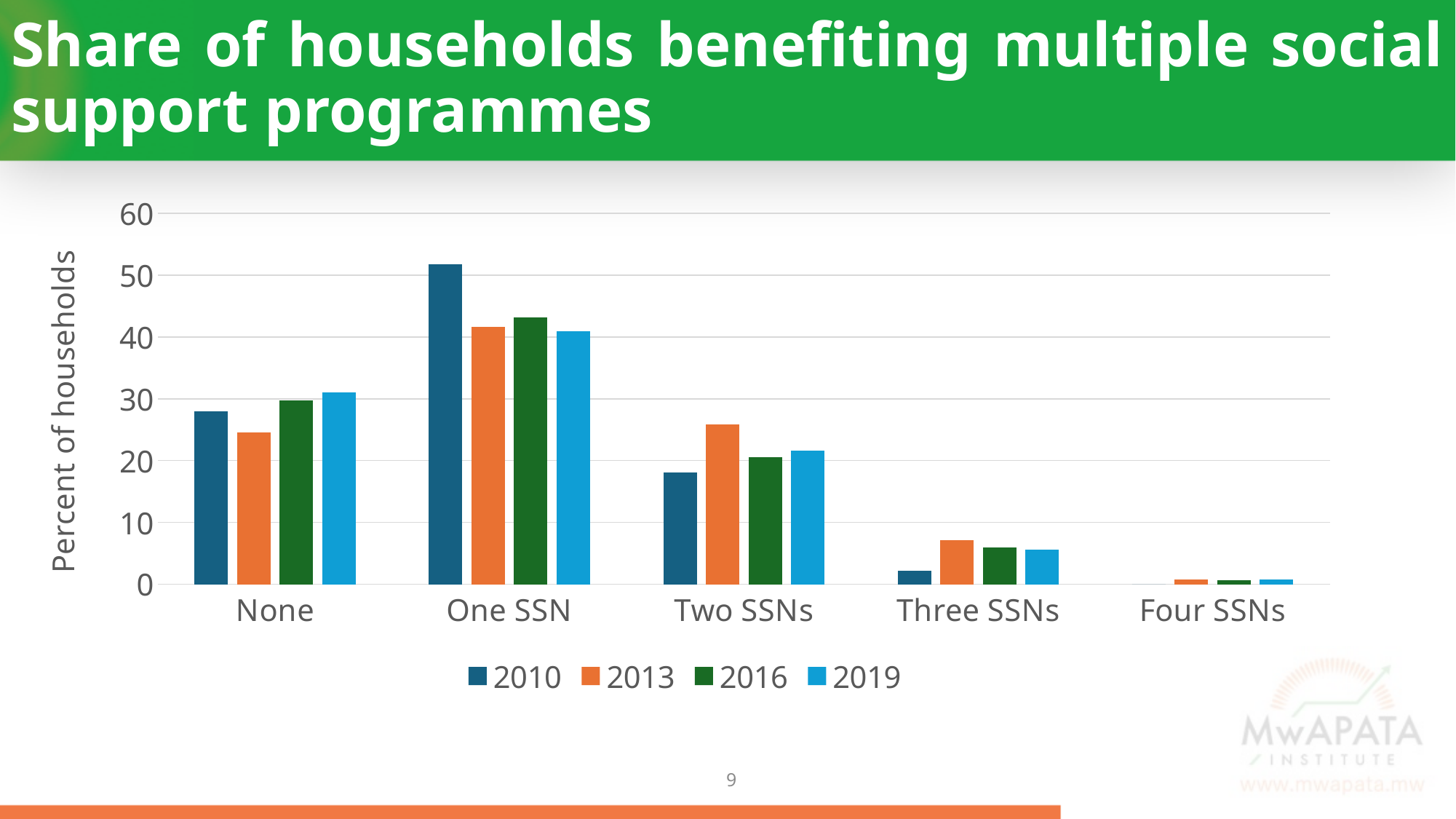
Is the 2013 value for None greater or less than 30? less For the Two SSNs category, which is larger: the 2010 value or the 2013 value? 2013 How many series does the legend list? 4 For the None category, which is larger: the 2010 value or the 2013 value? 2010 Which category has the lowest value for 2013? Four SSNs What kind of chart is shown on the slide? bar chart Which category has the highest value for 2010? One SSN Is the 2013 value for Two SSNs greater or less than 20? greater Is the 2016 value for Three SSNs greater or less than 10? less How many categories are shown on the x axis? 5 What is the title of the y axis? Percent of households